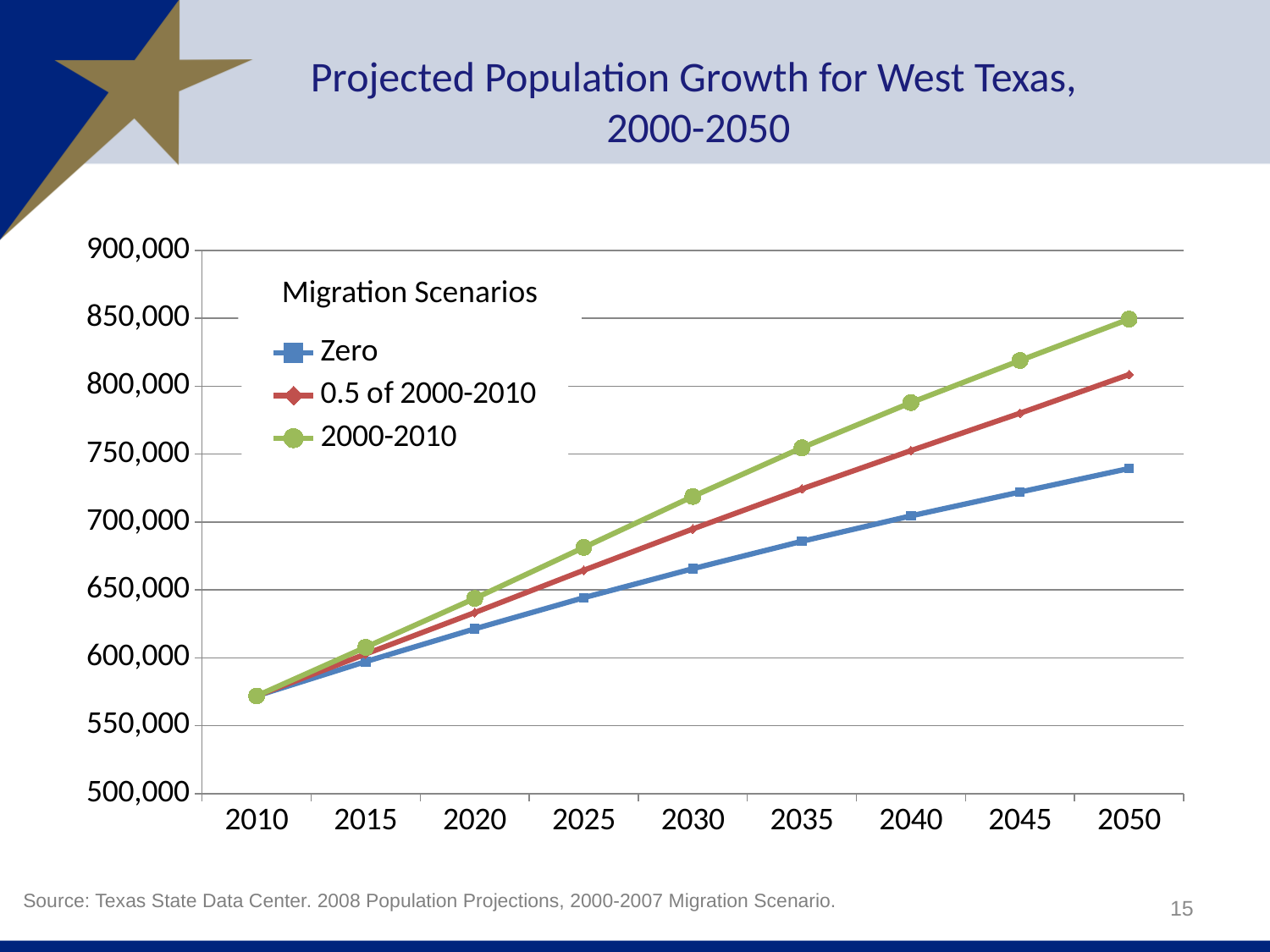
Is the value for the Zero scenario in 2050 greater or less than 750,000? less In 2030, which is larger: the value for the 0.5 of 2000-2010 scenario or the Zero scenario? 0.5 of 2000-2010 How many series does the legend list? 3 Is the value for the 2000-2010 scenario in 2040 greater or less than 750,000? greater How many years are marked along the x axis? 9 What kind of chart is shown on the slide? line chart Is the value for the Zero scenario in 2020 greater or less than 600,000? greater Which migration scenario has the lowest projected population in 2050? Zero Which migration scenario has the highest projected population in 2050? 2000-2010 What is the title of the chart? Projected Population Growth for West Texas, 2000-2050 Do the values for the Zero migration scenario rise or fall from 2010 to 2050? rise